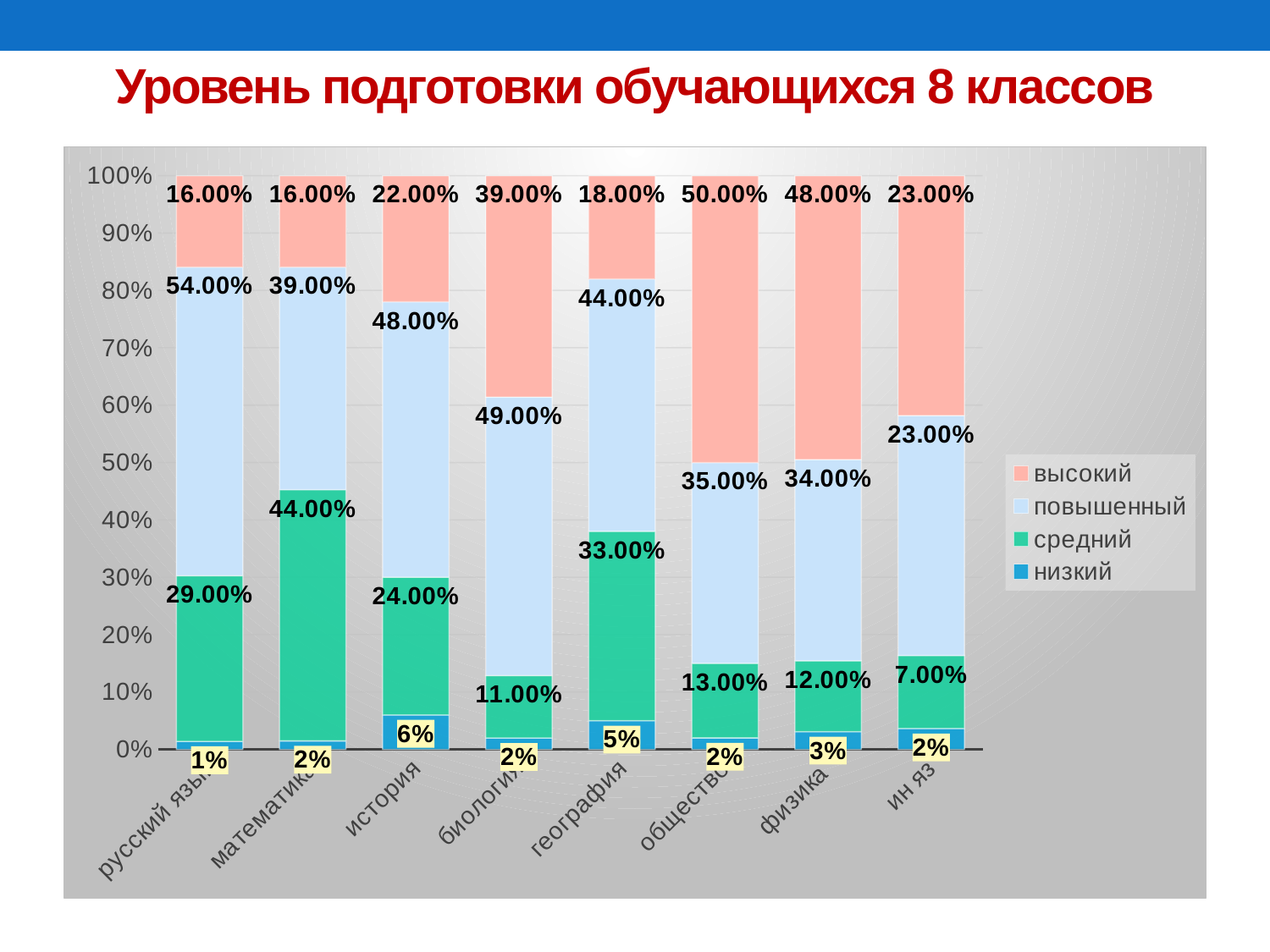
What is the value of the высокий series for история? 22.00% Which subject has the highest value in the низкий series? история What kind of chart is shown on the slide? stacked bar chart Which subject has the lowest value in the средний series? ин яз How many series does the legend list? 4 Which subject has the highest value in the средний series? математика What is the difference between the высокий values for физика and история? 26.00% Which has the larger повышенный value, история or география? история What is the value of the средний series for география? 33.00% What are the four entries listed in the legend? высокий, повышенный, средний, низкий How many subjects (categories) are shown on the x axis? 8 What is the value of the низкий series for физика? 3%